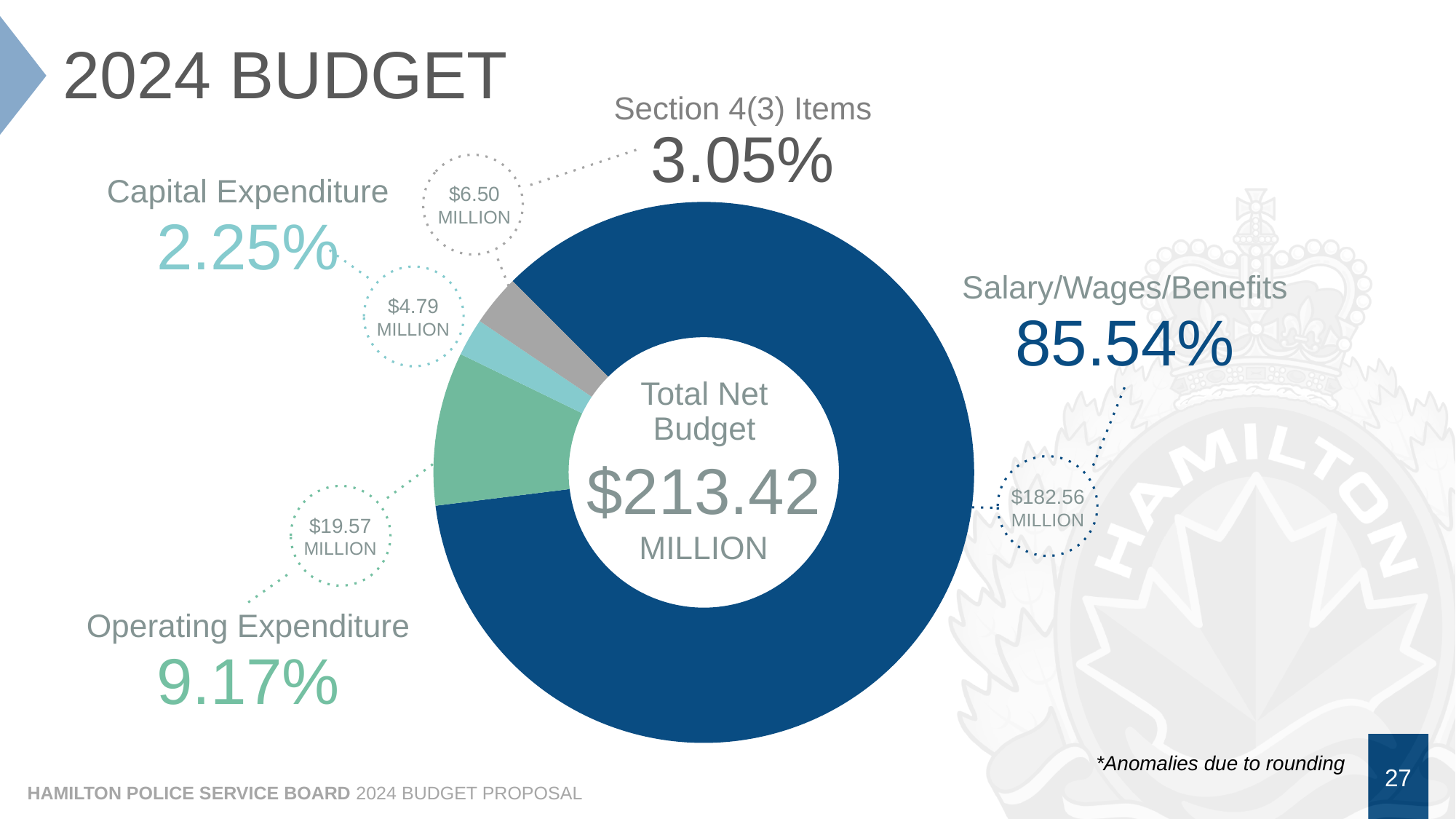
What is the dollar amount for Operating Expenditure? $19.57 million What share of the 2024 budget is Capital Expenditure? 2.25% Which category has the largest share of the 2024 budget? Salary/Wages/Benefits What is the dollar amount for Capital Expenditure? $4.79 million How many categories does the chart show? 4 What is the dollar amount for Salary/Wages/Benefits? $182.56 million Which category has the smallest share of the 2024 budget? Capital Expenditure What share of the 2024 budget is Operating Expenditure? 9.17% What kind of chart is shown on the slide? Donut (pie) chart What is the Total Net Budget shown in the centre of the chart? $213.42 million What share of the 2024 budget is Section 4(3) Items? 3.05%